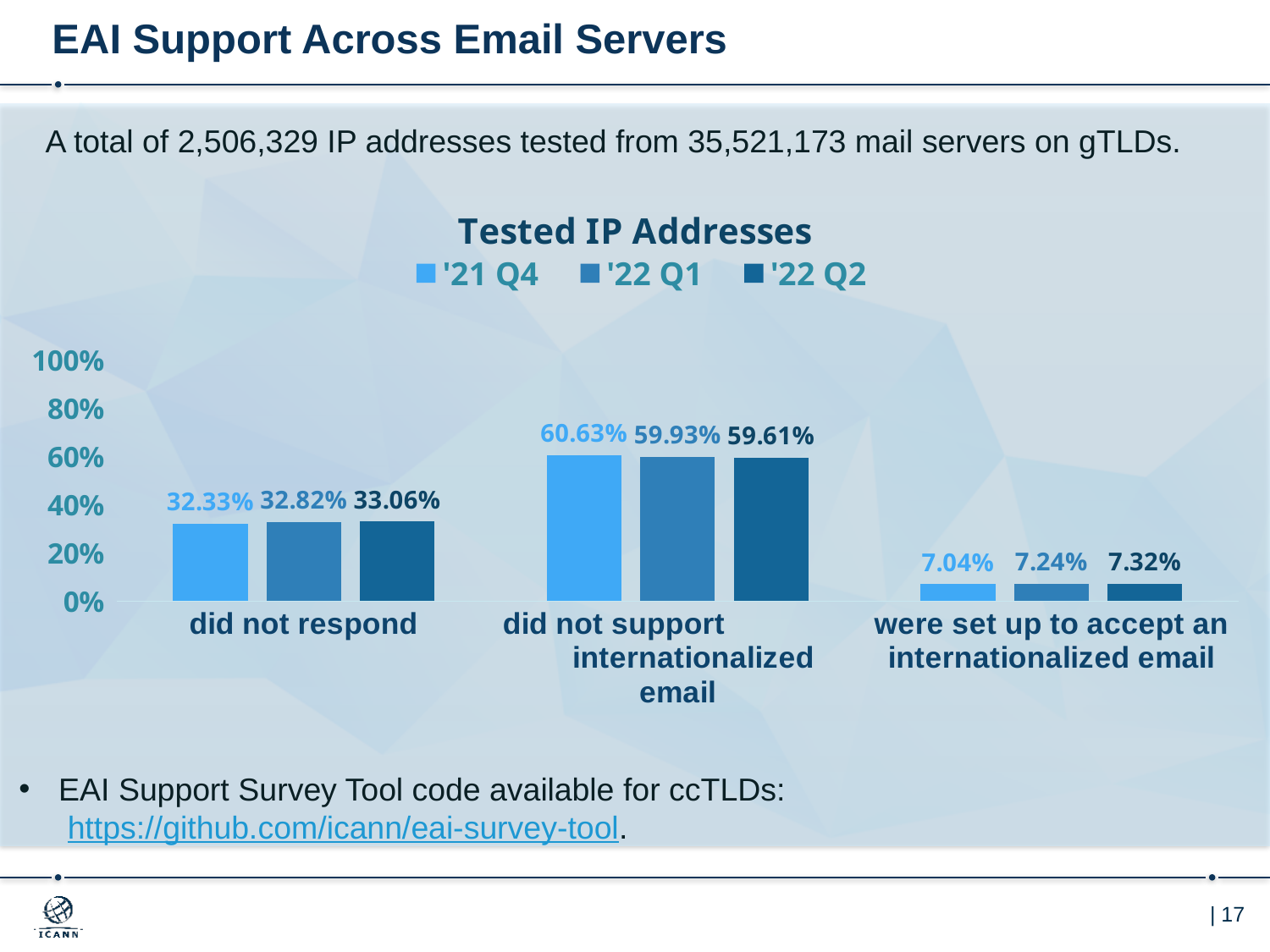
How many series does the legend list? 3 What is the value for '21 Q4 in the 'did not support internationalized email' category? 60.63% Which is larger: the '22 Q2 value for 'did not respond' or the '22 Q2 value for 'were set up to accept an internationalized email'? did not respond Is the '22 Q1 value for 'did not respond' greater or less than 40%? less What is the difference between the '21 Q4 and '22 Q2 values for 'did not support internationalized email'? 1.02% Which category has the highest values across all series? did not support internationalized email Which category has the lowest values across all series? were set up to accept an internationalized email What kind of chart is shown? bar chart What is the value for '22 Q2 in the 'did not respond' category? 33.06% What is the title of the chart? Tested IP Addresses What is the value for '22 Q1 in the 'were set up to accept an internationalized email' category? 7.24% How many categories are shown on the x axis? 3